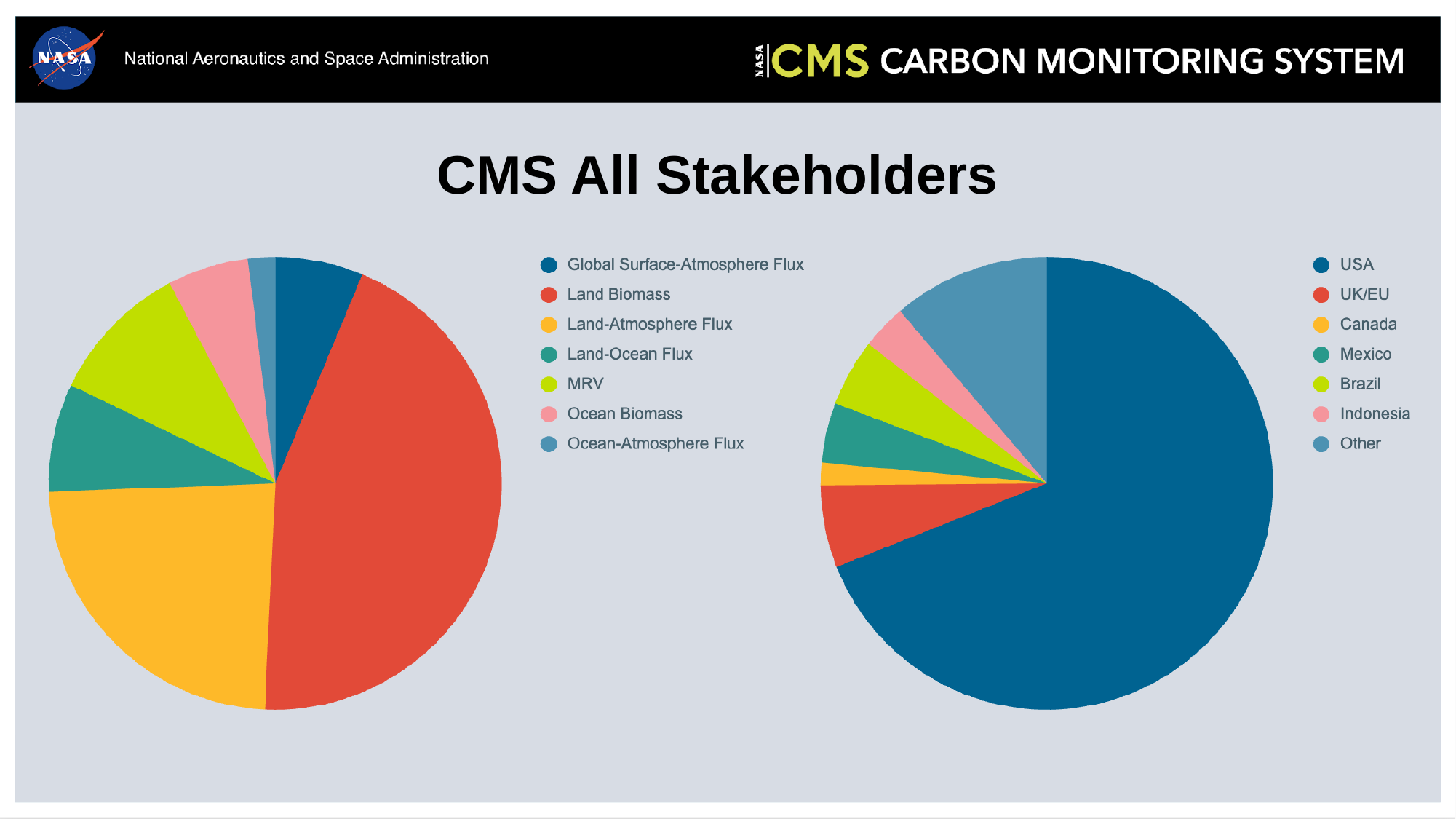
How many categories does the right pie chart's legend list? 7 In the left pie chart, which slice is larger: Land Biomass or Land-Atmosphere Flux? Land Biomass In the left pie chart, which slice is larger: MRV or Ocean Biomass? MRV In the right pie chart, which category has the smallest slice? Canada In the left pie chart, which category has the smallest slice? Ocean-Atmosphere Flux How many categories does the left pie chart's legend list? 7 In the right pie chart, which slice is larger: UK/EU or Canada? UK/EU What kind of chart is the left chart on the slide? pie chart What is the title shown above the two pie charts? CMS All Stakeholders In the left pie chart, which category has the largest slice? Land Biomass In the right pie chart, which category has the largest slice? USA